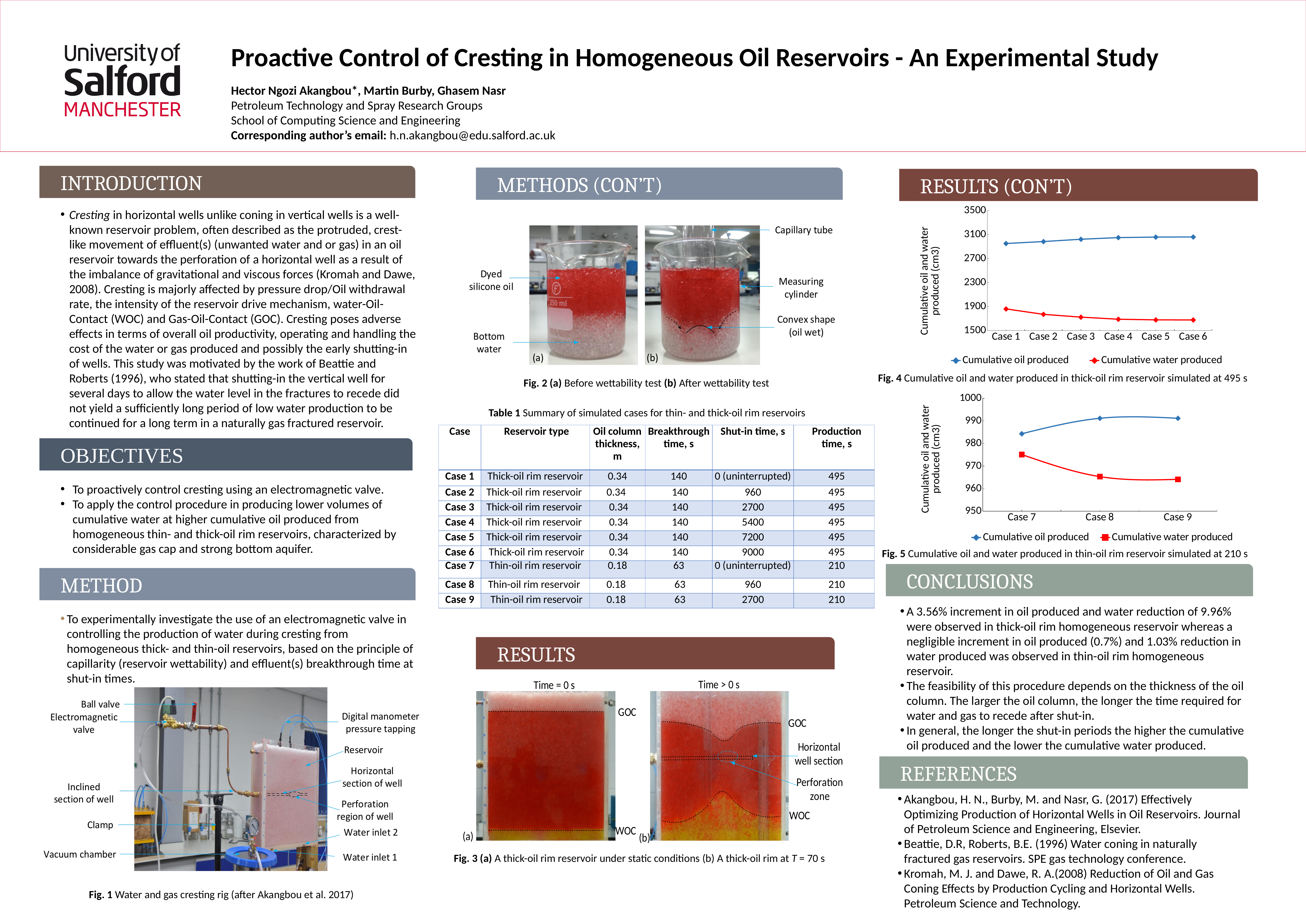
How many series does the legend of Fig. 5 (thin-oil rim reservoir) list? 2 In Fig. 5 (thin-oil rim reservoir), what colour is the line for cumulative water produced? Red In Fig. 4 (thick-oil rim reservoir), which case has the highest cumulative water produced? Case 1 In Fig. 4 (thick-oil rim reservoir), is the cumulative oil produced for Case 1 greater or less than 2700? greater In Fig. 5 (thin-oil rim reservoir), is the cumulative water produced for Case 8 greater or less than 970? less How many cases are plotted along the x axis of Fig. 5 (thin-oil rim reservoir)? 3 In Fig. 4 (thick-oil rim reservoir), which is larger for Case 1: cumulative oil produced or cumulative water produced? Cumulative oil produced What kind of chart is Fig. 4 (cumulative oil and water produced in thick-oil rim reservoir)? Line chart How many cases are plotted along the x axis of Fig. 4 (thick-oil rim reservoir)? 6 In Fig. 5 (thin-oil rim reservoir), which case has the lowest cumulative oil produced? Case 7 In Fig. 4 (thick-oil rim reservoir), is the cumulative water produced for Case 6 greater or less than 1900? less In Fig. 4 (thick-oil rim reservoir), does cumulative water produced rise or fall from Case 1 to Case 6? Fall